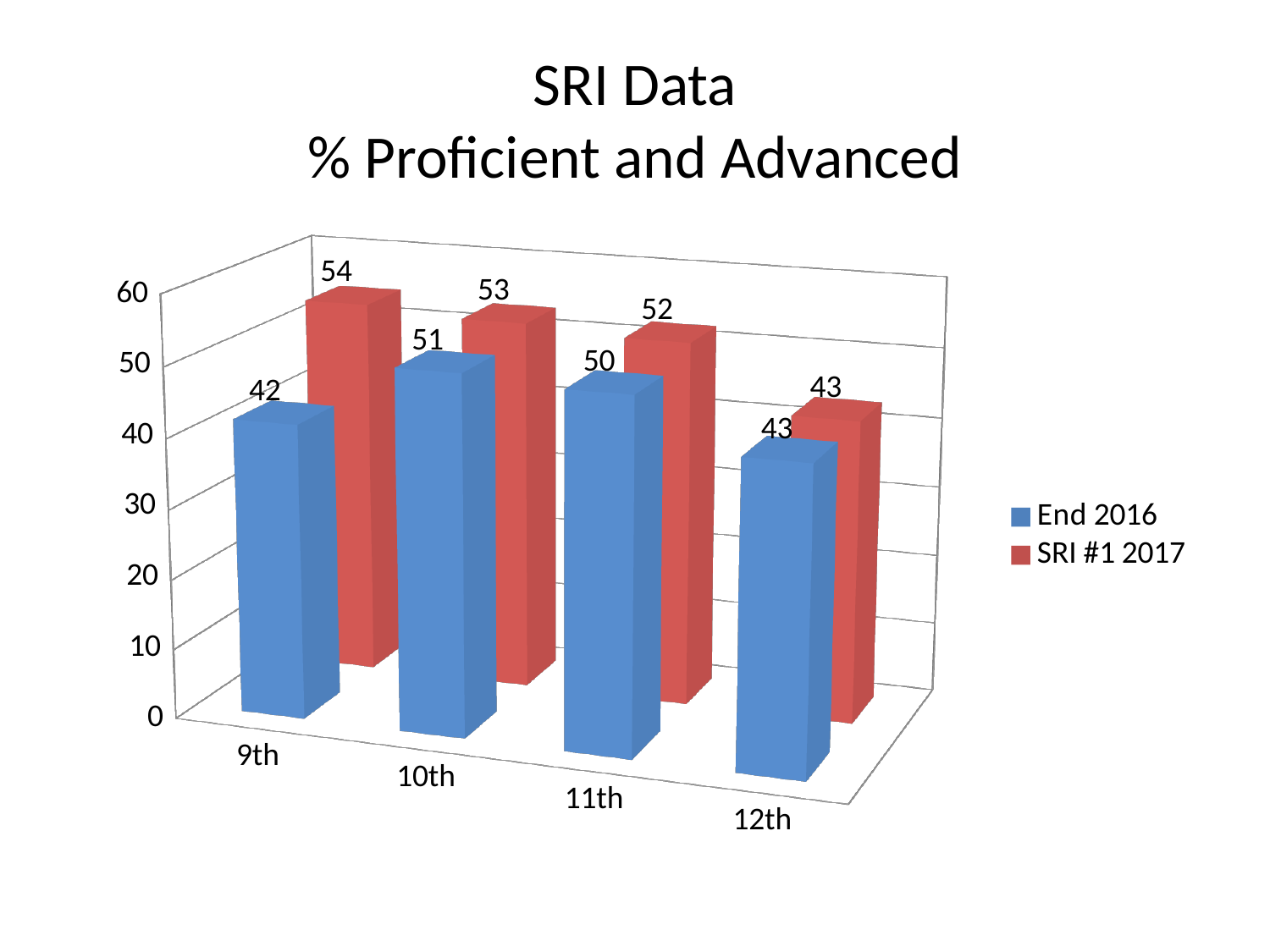
What is the title of the chart? SRI Data % Proficient and Advanced How many grade categories are shown on the x axis? 4 Which grade has the highest SRI #1 2017 value? 9th What is the difference between the SRI #1 2017 and End 2016 values for 9th grade? 12 How many series does the legend list? 2 What kind of chart is shown on the slide? Bar chart Which grade has the lowest End 2016 value? 9th What is the End 2016 value for 9th grade? 42 What is the SRI #1 2017 value for 11th grade? 52 Which colour represents the SRI #1 2017 series? Red What is the SRI #1 2017 value for 12th grade? 43 Which is larger for 10th grade, End 2016 or SRI #1 2017? SRI #1 2017